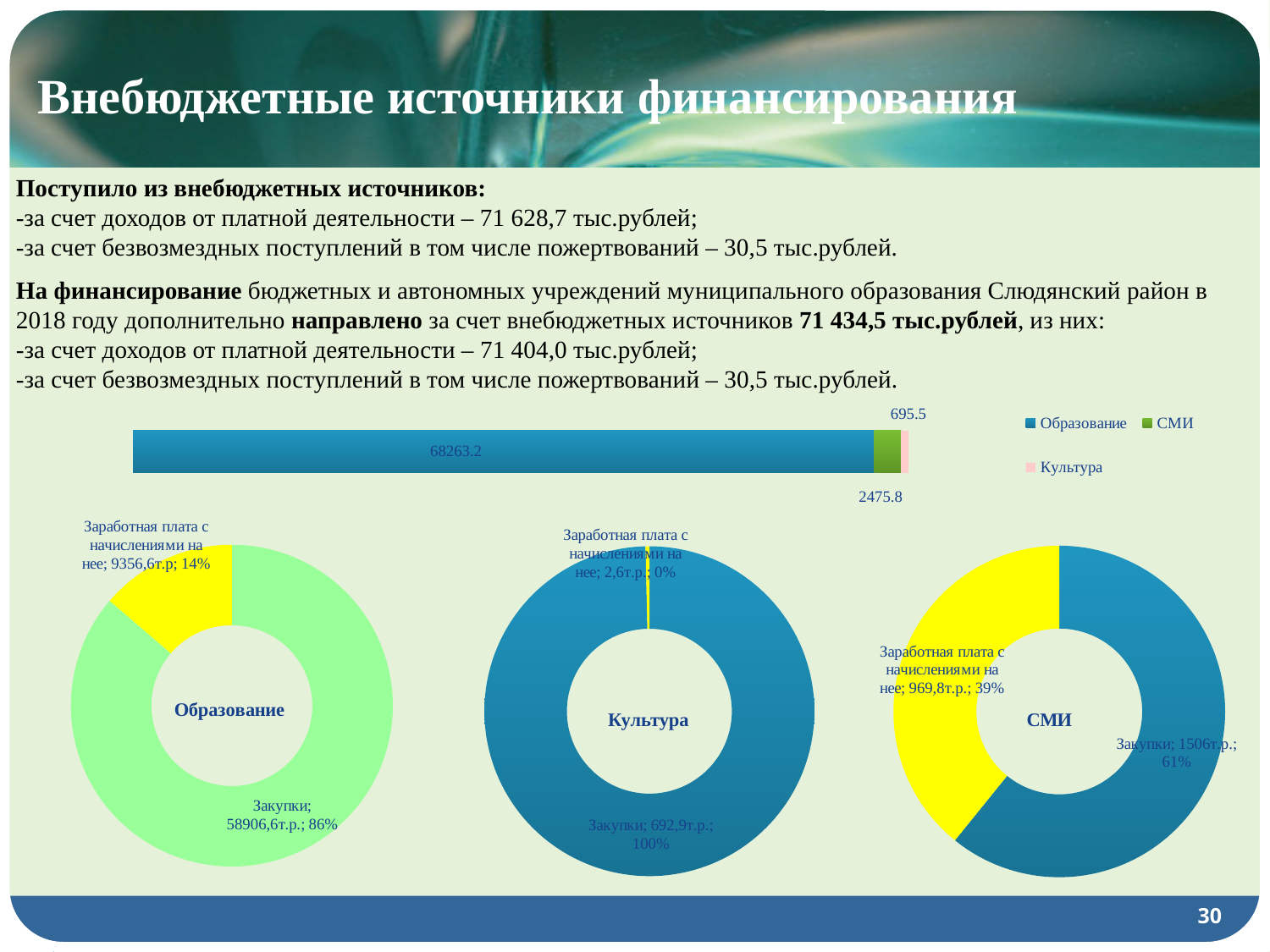
In the stacked bar chart at the top of the slide, what is the value for Культура? 695.5 In the Образование doughnut chart, what share does Заработная плата с начислениями на нее have? 14% In the stacked bar chart at the top of the slide, what is the value for Образование? 68263.2 What kind of chart is the Образование chart at the bottom left of the slide? Doughnut chart How many series does the legend of the stacked bar chart at the top of the slide list? 3 In the СМИ doughnut chart, which is larger, Закупки or Заработная плата с начислениями на нее? Закупки In the Культура doughnut chart, what share does Закупки have? 100% In the stacked bar chart at the top of the slide, which series has the largest value? Образование In the Образование doughnut chart, what is the value for Закупки? 58906,6т.р. In the stacked bar chart at the top of the slide, what is the total of the stacked bar? 71434.5 In the stacked bar chart at the top of the slide, what is the value for СМИ? 2475.8 In the Образование doughnut chart, what is the difference between Закупки and Заработная плата с начислениями на нее? 49550,0т.р.